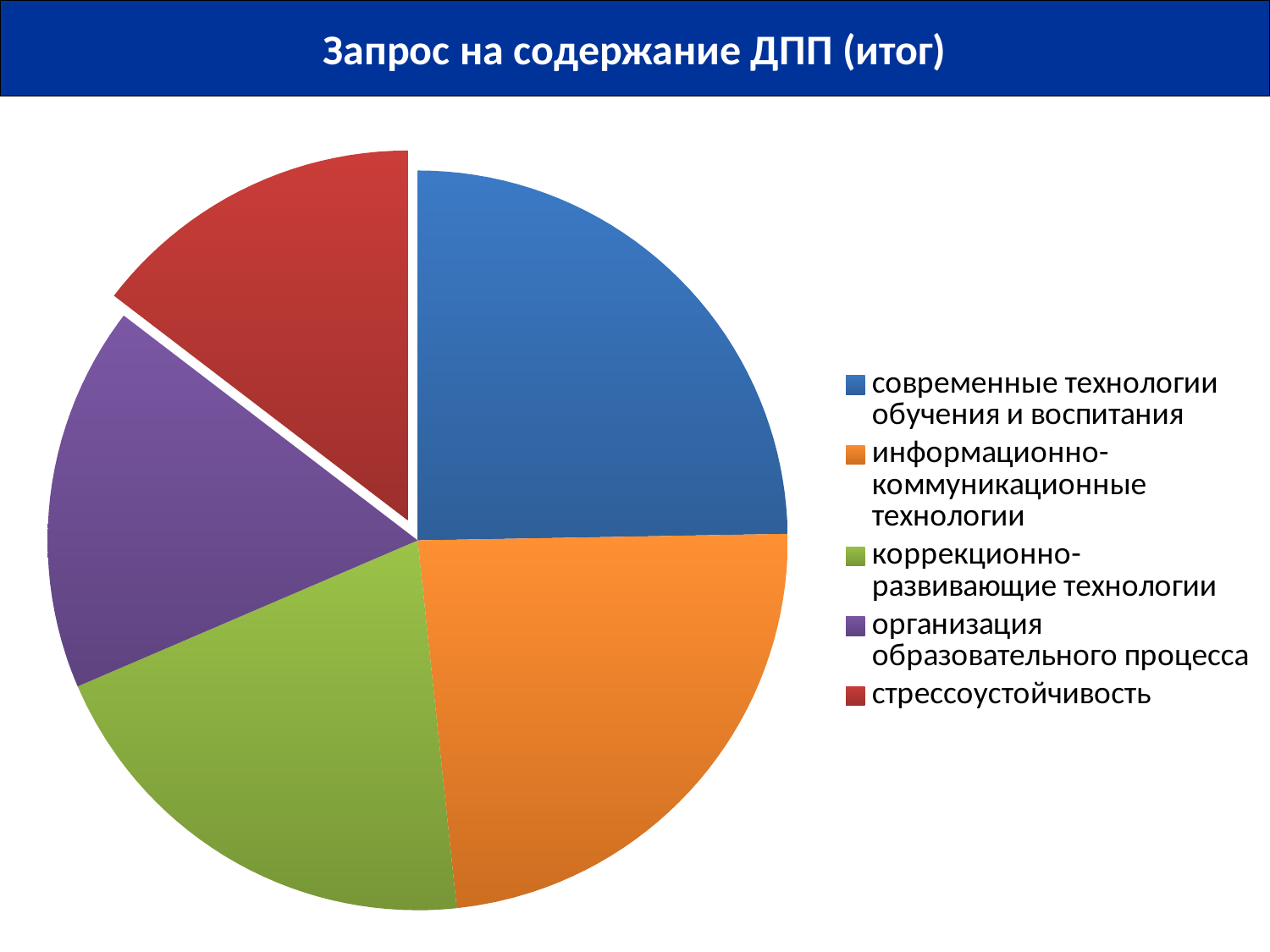
How many slices does the pie chart have? 5 Which legend entry is shown in blue on the pie chart? современные технологии обучения и воспитания Which slice is larger: 'современные технологии обучения и воспитания' or 'стрессоустойчивость'? современные технологии обучения и воспитания Which slice is larger: 'коррекционно-развивающие технологии' or 'стрессоустойчивость'? коррекционно-развивающие технологии Which slice is larger: 'информационно-коммуникационные технологии' or 'стрессоустойчивость'? информационно-коммуникационные технологии What is the title of the slide with the pie chart? Запрос на содержание ДПП (итог) What kind of chart is shown on the slide? pie chart How many entries does the legend of the pie chart list? 5